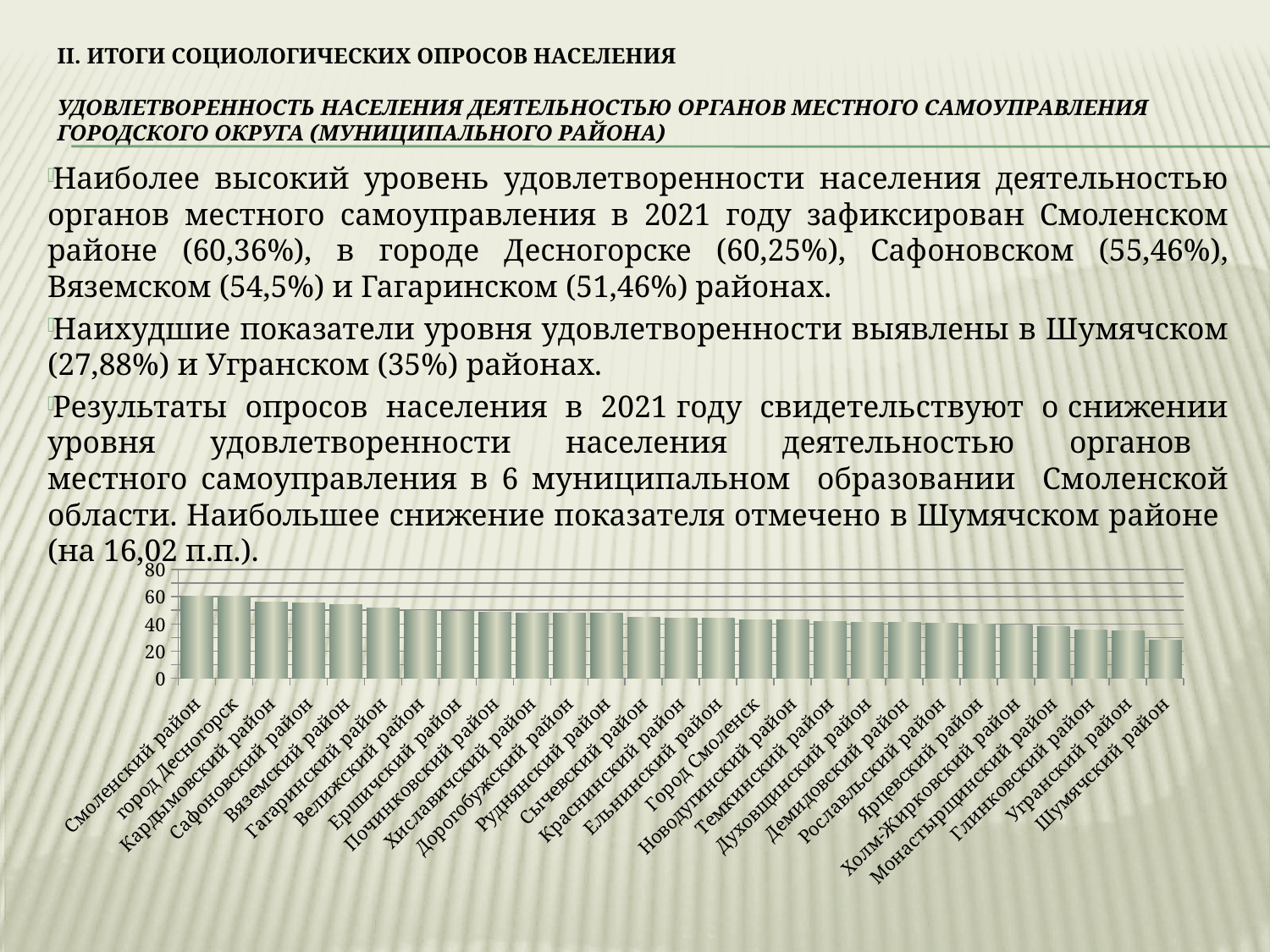
Do the bar values rise or fall moving from left to right along the x axis? fall Is the value for Сафоновский район greater or less than 40? greater How many categories (municipalities) are shown on the x axis of the chart? 27 Is the value for Город Смоленск greater or less than 20? greater Is the value for Шумячский район greater or less than 40? less Which is larger, the value for Смоленский район or the value for Шумячский район? Смоленский район Which category has the lowest bar in the chart? Шумячский район What kind of chart is shown on the slide? bar chart What is the highest tick value shown on the vertical axis of the chart? 80